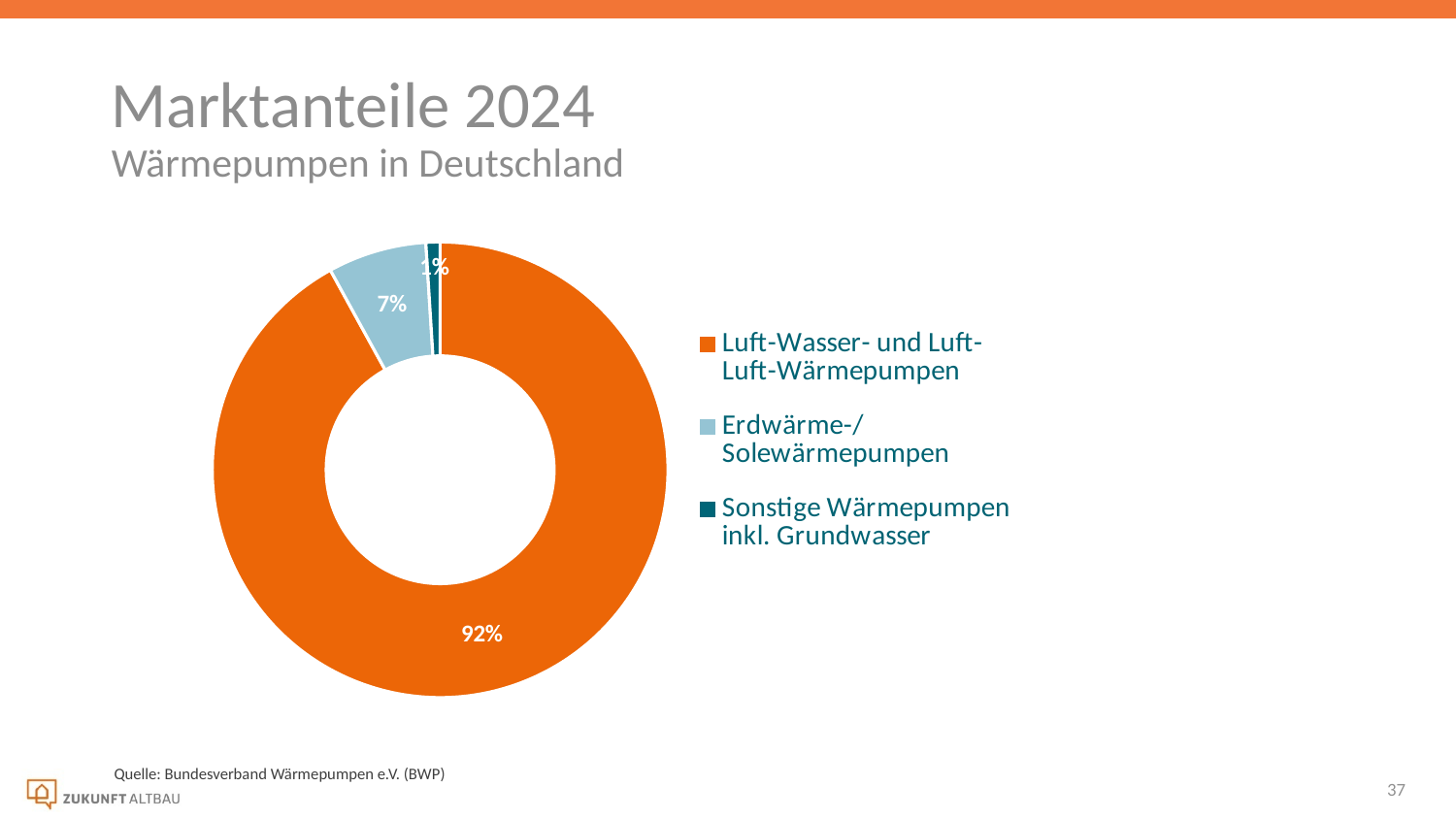
How many entries does the legend list? 3 Which category has the smallest share of the chart? Sonstige Wärmepumpen inkl. Grundwasser What colour represents Erdwärme-/Solewärmepumpen in the chart? Light blue What is the title of the slide containing the chart? Marktanteile 2024 – Wärmepumpen in Deutschland What share of the market do Luft-Wasser- und Luft-Luft-Wärmepumpen hold? 92% Which has a larger share: Erdwärme-/Solewärmepumpen or Sonstige Wärmepumpen inkl. Grundwasser? Erdwärme-/Solewärmepumpen What share of the market do Sonstige Wärmepumpen inkl. Grundwasser hold? 1% Which category has the largest share of the chart? Luft-Wasser- und Luft-Luft-Wärmepumpen What is the difference in percentage points between the share of Luft-Wasser- und Luft-Luft-Wärmepumpen and Erdwärme-/Solewärmepumpen? 85 percentage points How many categories are shown in the chart? 3 What share of the market do Erdwärme-/Solewärmepumpen hold? 7% What kind of chart is shown on the slide? Doughnut (pie) chart